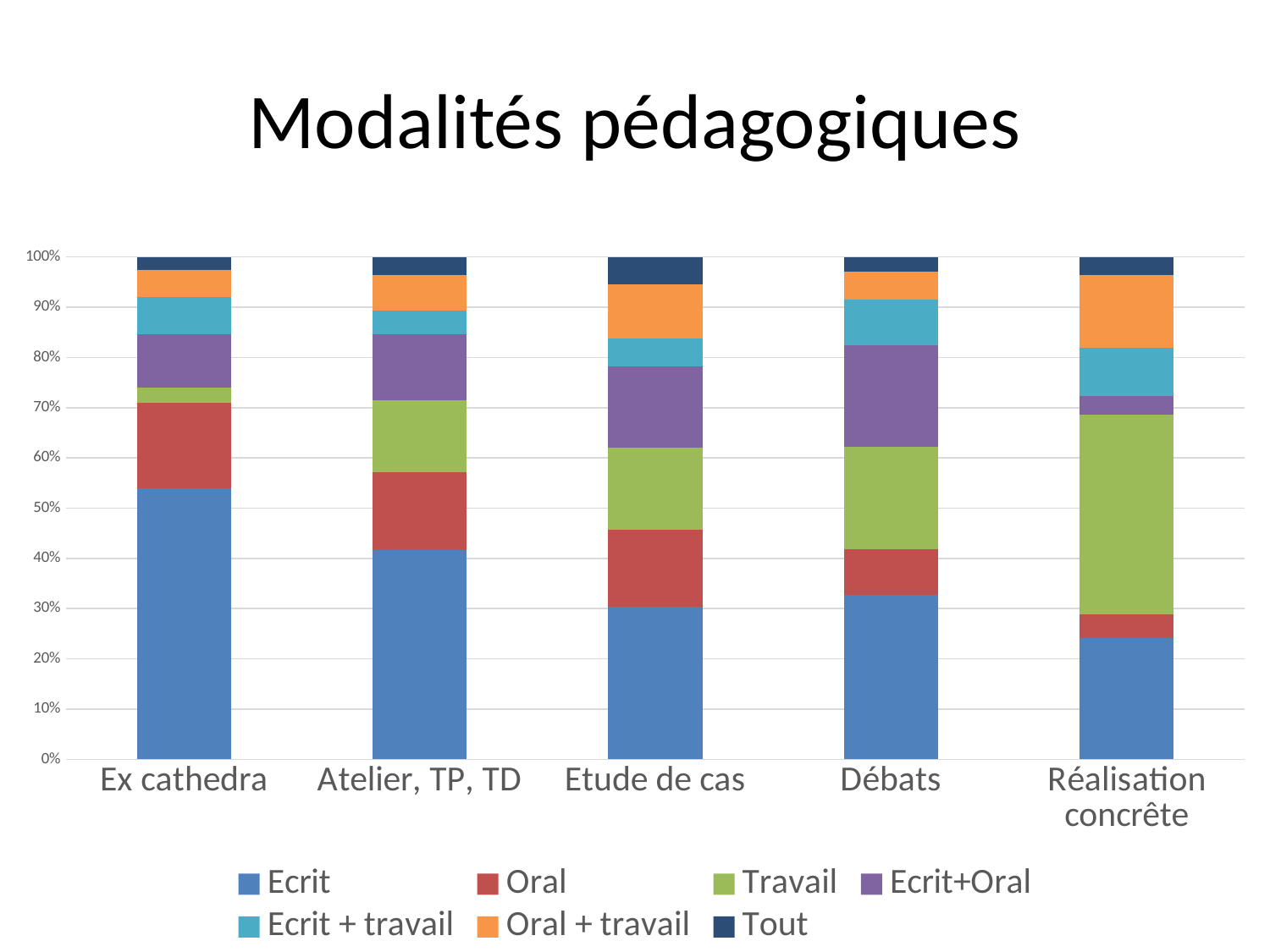
What kind of chart is shown on the slide? Stacked bar chart How many categories are shown on the x axis? 5 Which series is shown in green in the legend? Travail How many series does the legend list? 7 Is the Ecrit share for Réalisation concrête greater or less than 30%? less Which category has the largest Travail segment? Réalisation concrête What is the title of the chart? Modalités pédagogiques Is the Ecrit share for Ex cathedra greater or less than 50%? greater Which has a larger Ecrit segment, Ex cathedra or Atelier, TP, TD? Ex cathedra Which category has the smallest Ecrit segment? Réalisation concrête Which category has the smallest Travail segment? Ex cathedra Which category has the largest Ecrit segment? Ex cathedra